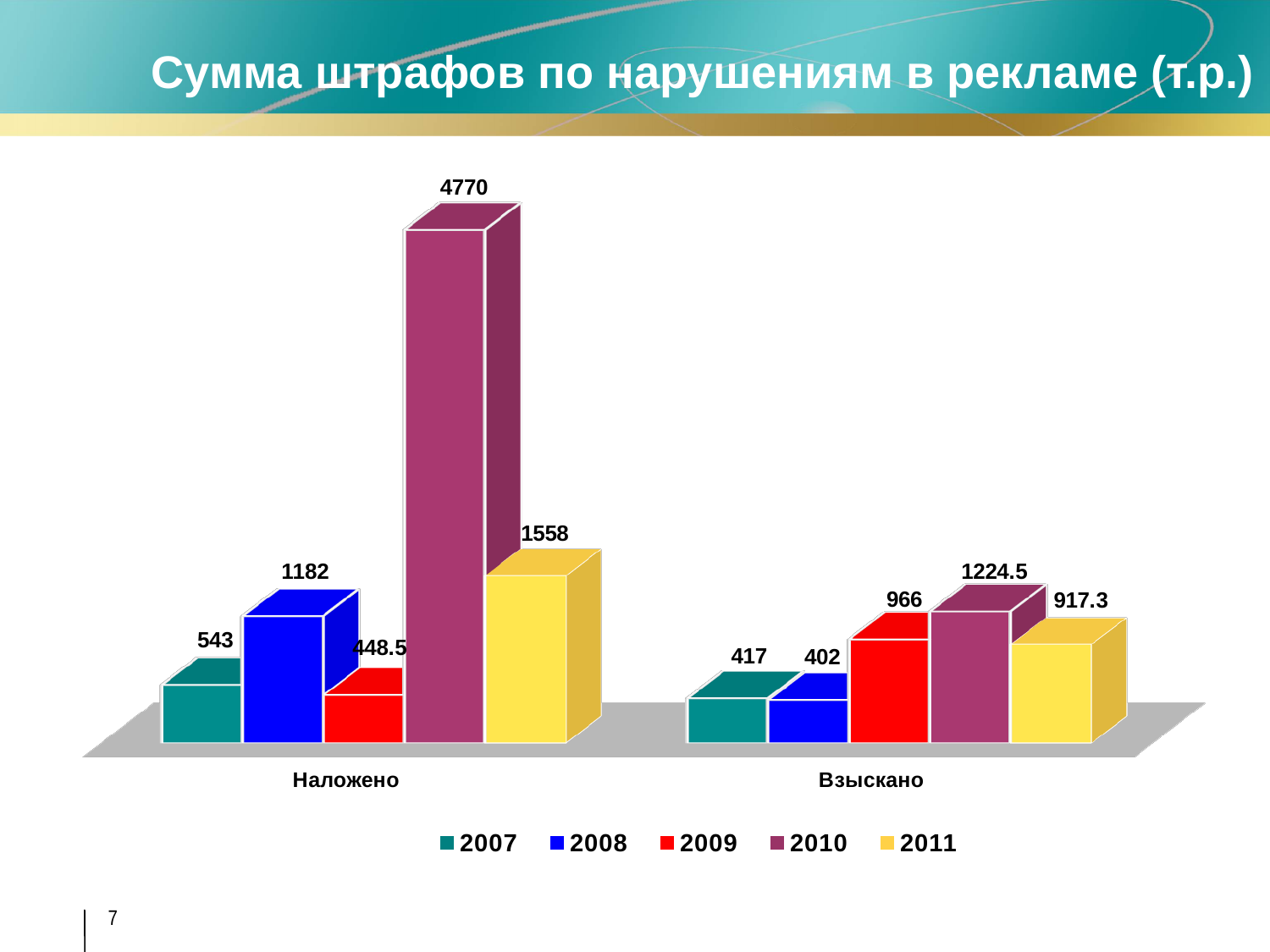
What is the title of the chart? Сумма штрафов по нарушениям в рекламе (т.р.) What is the value for 2007 in the Взыскано category? 417 What is the value for 2010 in the Наложено category? 4770 Which year has the lowest value in the Взыскано category? 2008 How many categories are shown on the x axis? 2 How many series does the legend list? 5 What kind of chart is shown on the slide? bar chart What is the value for 2011 in the Наложено category? 1558 Which is larger: the 2008 value for Наложено or the 2008 value for Взыскано? Наложено What is the value for 2009 in the Взыскано category? 966 Which year has the highest value in the Наложено category? 2010 What is the difference between the 2010 values for Наложено and Взыскано? 3545.5